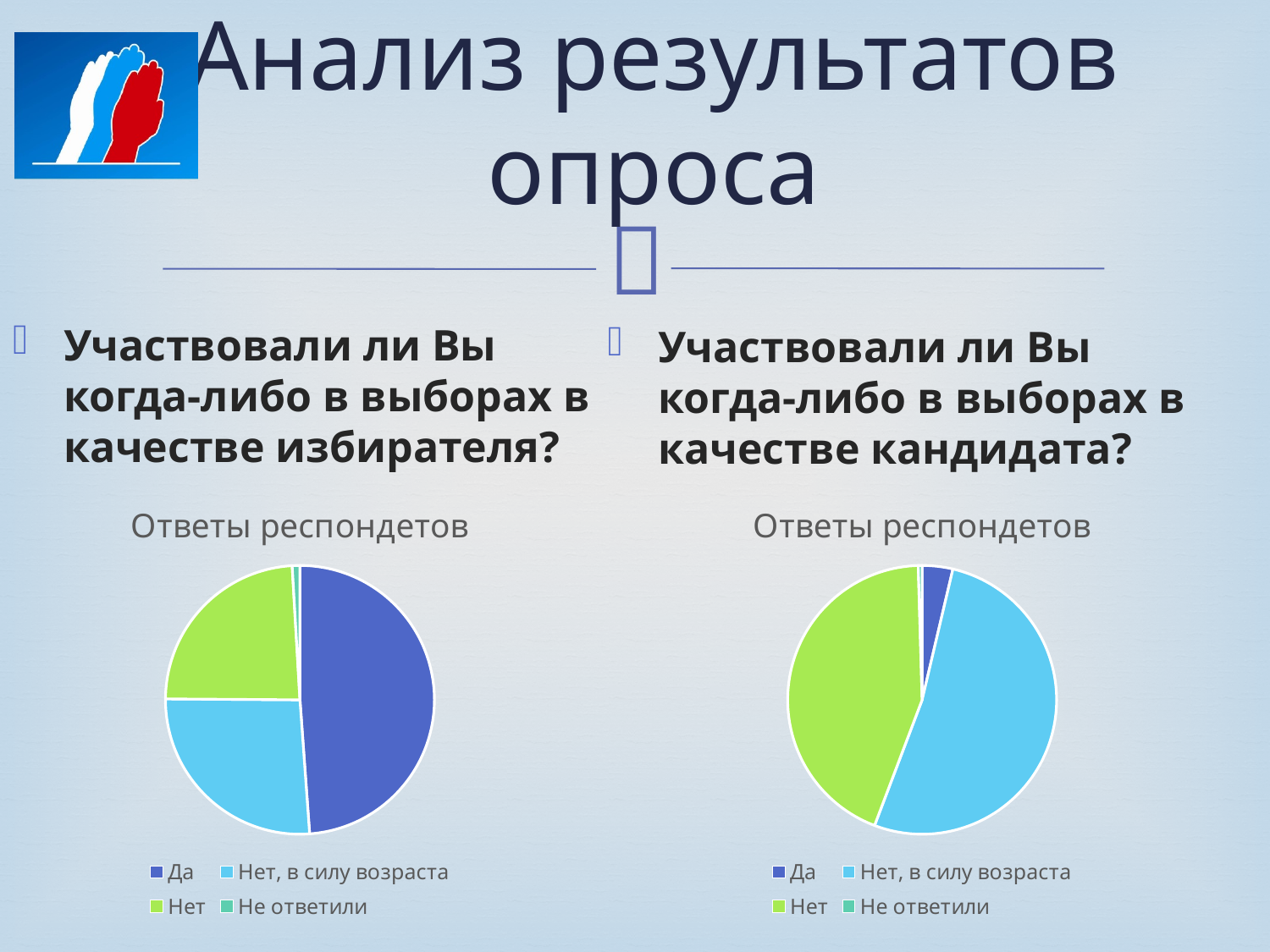
How many charts are shown on the slide? 2 What is the title of the left chart? Ответы респондетов In the legend of the right chart, which colour represents Да? dark blue In the left chart (about participating as a voter), which category has the largest slice? Да In the right chart (about participating as a candidate), which slice is larger: Да or Нет, в силу возраста? Нет, в силу возраста In the left chart (about participating as a voter), which slice is larger: Да or Нет? Да In the right chart (about participating as a candidate), which slice is larger: Да or Нет? Нет What kind of chart is the right chart (under the question about participating as a candidate)? pie chart What kind of chart is the left chart (under the question about participating as a voter)? pie chart How many entries does the legend of the right chart list? 4 How many entries does the legend of the left chart list? 4